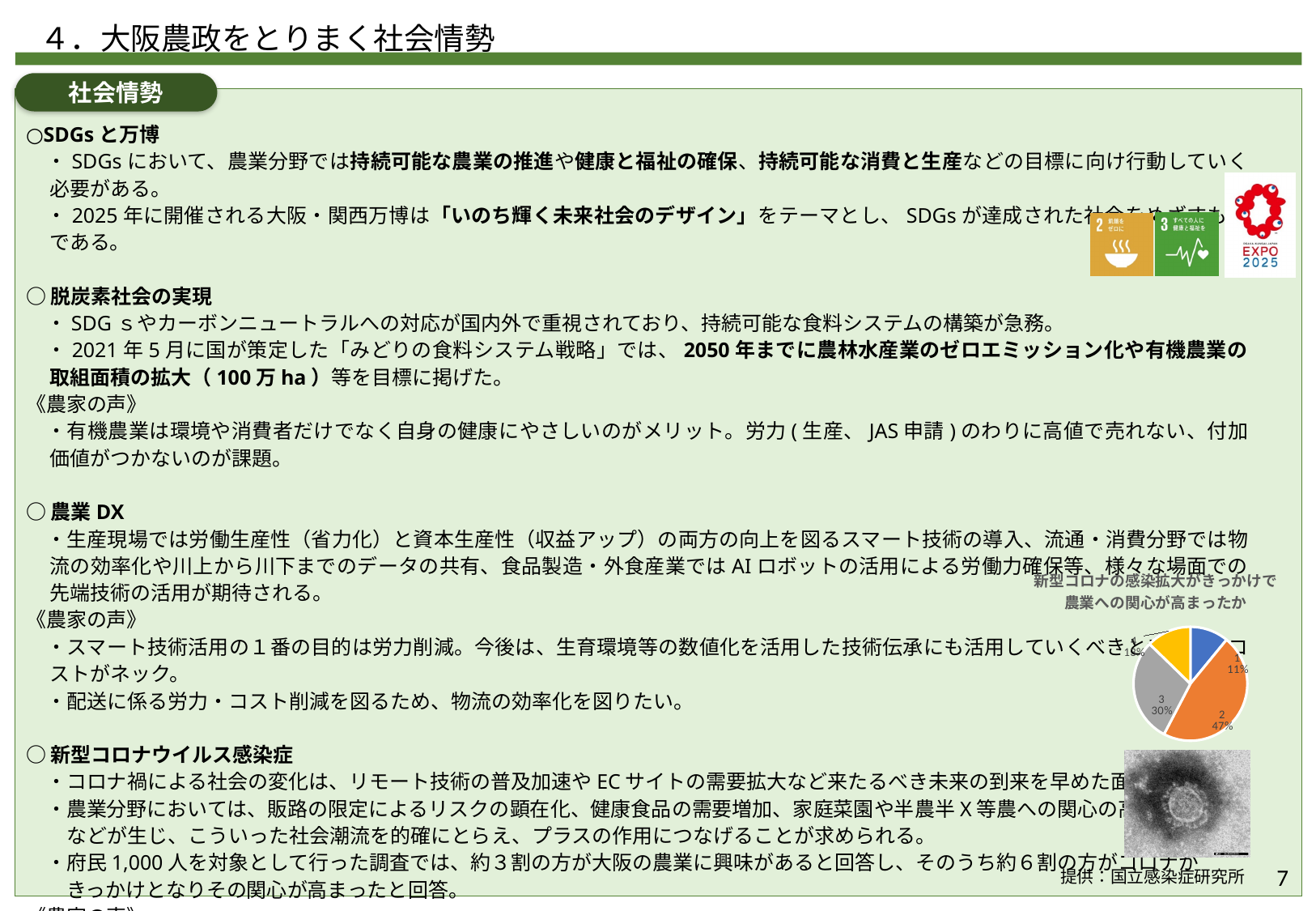
What kind of chart is shown on the slide? pie chart Which is larger in the pie chart, slice 2 or slice 3? slice 2 What colour is the largest slice (slice 2) in the pie chart? orange What is the difference in percentage points between slice 2 and slice 3 in the pie chart? 17 What percentage is shown for slice 3 in the pie chart? 30% How many slices does the pie chart have? 4 What is the title of the pie chart on the slide? 新型コロナの感染拡大がきっかけで農業への関心が高まったか Which slice of the pie chart is the largest? 2 What percentage is shown for slice 2 in the pie chart? 47% What is the difference in percentage points between slice 3 and slice 1 in the pie chart? 19 Which is larger in the pie chart, slice 3 or slice 1? slice 3 What percentage is shown for slice 1 in the pie chart? 11%